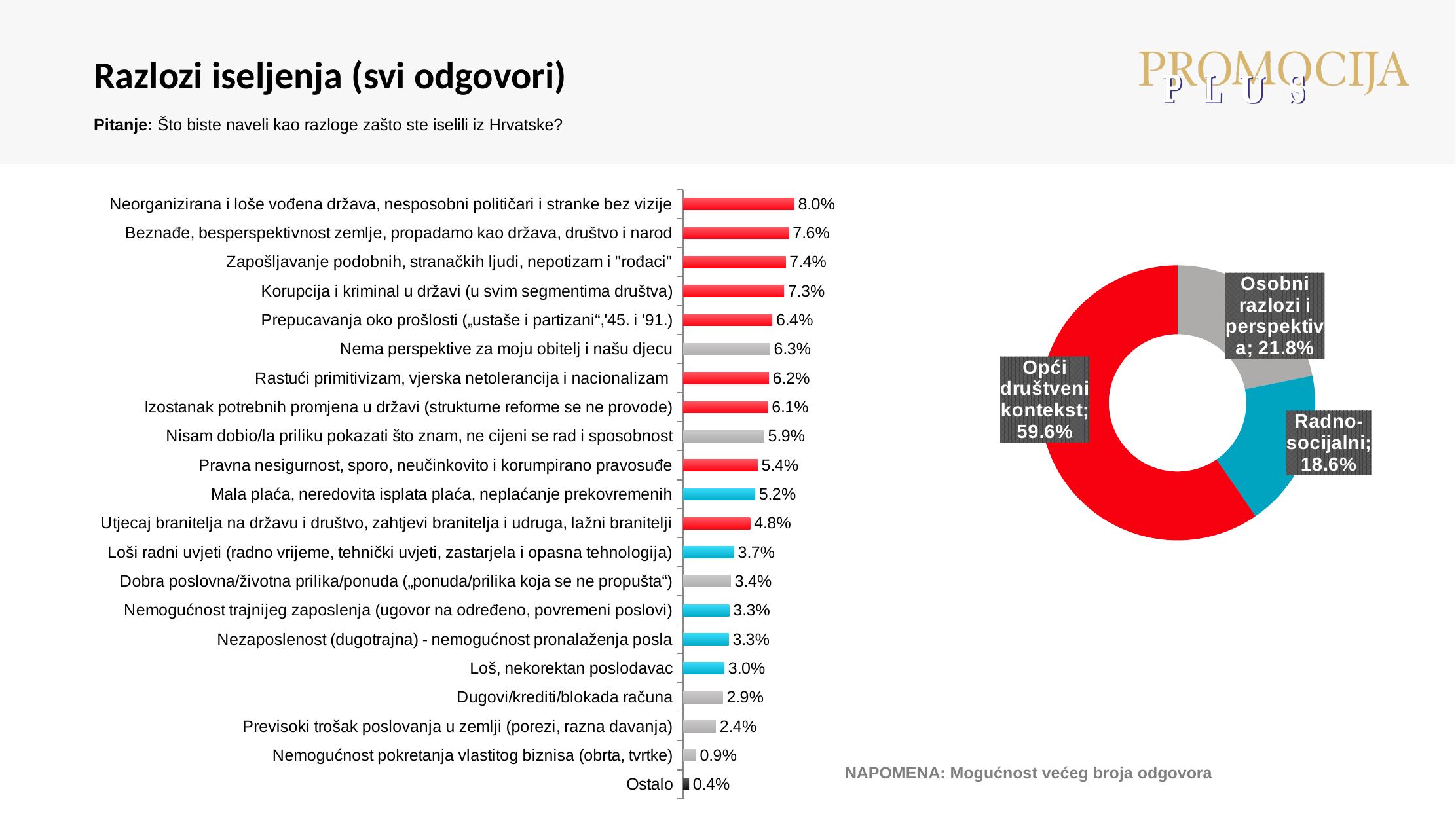
In the bar chart on the left, which category has the highest value? Neorganizirana i loše vođena država, nesposobni političari i stranke bez vizije In the bar chart on the left, which is larger: the value for "Loši radni uvjeti (radno vrijeme, tehnički uvjeti, zastarjela i opasna tehnologija)" or for "Dugovi/krediti/blokada računa"? Loši radni uvjeti (radno vrijeme, tehnički uvjeti, zastarjela i opasna tehnologija) How many slices does the donut chart on the right have? 3 In the donut chart on the right, what is the share for "Opći društveni kontekst"? 59.6% In the bar chart on the left, what is the difference between the values for "Neorganizirana i loše vođena država, nesposobni političari i stranke bez vizije" and "Beznađe, besperspektivnost zemlje, propadamo kao država, društvo i narod"? 0.4% What kind of chart is the chart on the left of the slide? Bar chart In the bar chart on the left, what is the value for "Korupcija i kriminal u državi (u svim segmentima društva)"? 7.3% In the bar chart on the left, what is the value for "Mala plaća, neredovita isplata plaća, neplaćanje prekovremenih"? 5.2% In the donut chart on the right, what is the share for "Radno-socijalni"? 18.6% How many categories are shown in the bar chart on the left? 21 In the donut chart on the right, what is the difference between the shares for "Osobni razlozi i perspektiva" and "Radno-socijalni"? 3.2% In the bar chart on the left, which category has the lowest value? Ostalo